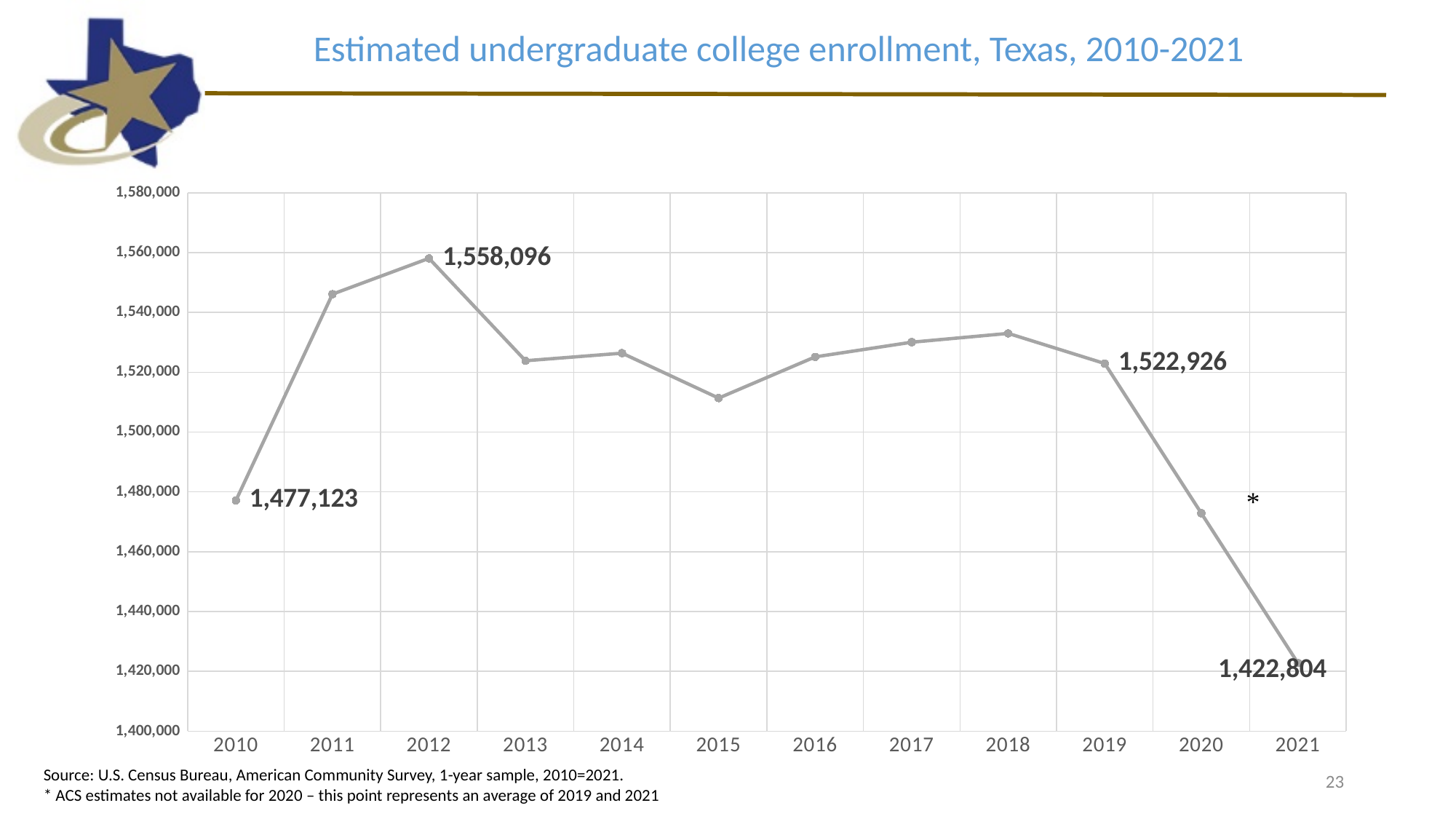
Which year has the highest estimated undergraduate college enrollment? 2012 Which year has the lowest estimated undergraduate college enrollment? 2021 Is the value for 2015 greater or less than 1,520,000? less What is the estimated undergraduate college enrollment in Texas for 2012? 1,558,096 What is the difference between the enrollment in 2012 and the enrollment in 2010? 80,973 Which year has the larger enrollment, 2019 or 2021? 2019 What is the estimated undergraduate college enrollment in Texas for 2010? 1,477,123 What is the estimated undergraduate college enrollment in Texas for 2021? 1,422,804 Is the value for 2011 greater or less than 1,540,000? greater What kind of chart is shown on the slide? Line chart How many years are plotted on the chart? 12 What is the difference between the enrollment in 2019 and the enrollment in 2021? 100,122